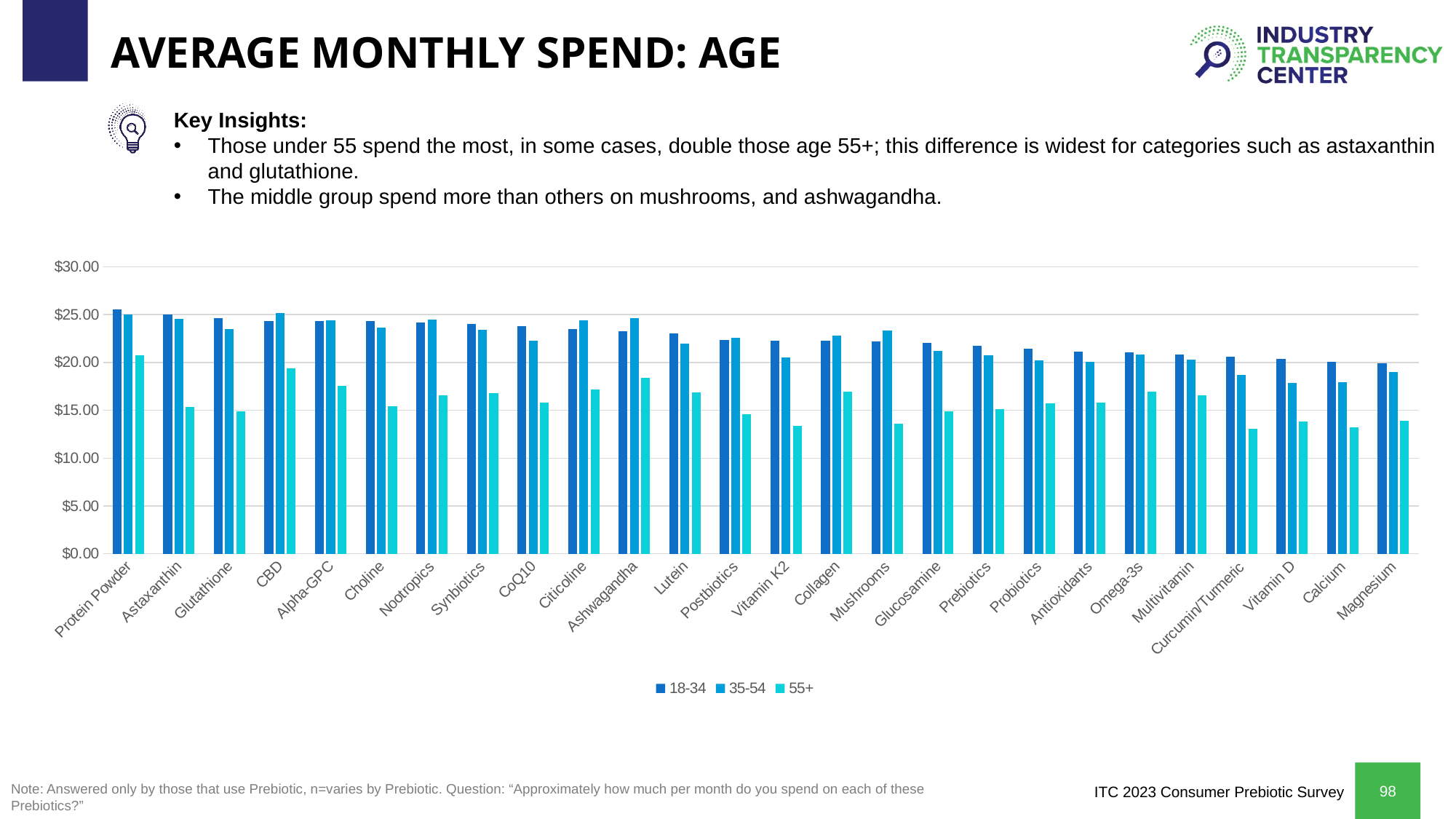
How many supplement categories are shown on the x axis? 26 What kind of chart is shown on the slide? bar chart Is the value for CBD in the 55+ series greater or less than $20.00? less Do the 18-34 series values generally rise or fall from left to right along the x axis? fall What is the title of the chart slide? AVERAGE MONTHLY SPEND: AGE Is the value for Protein Powder in the 18-34 series greater or less than $25.00? greater Is the value for Lutein in the 18-34 series greater or less than $20.00? greater For Mushrooms, which series has the larger value, 18-34 or 35-54? 35-54 How many series does the legend list? 3 For Astaxanthin, which series has the larger value, 18-34 or 55+? 18-34 Which category has the highest value in the 55+ series? Protein Powder